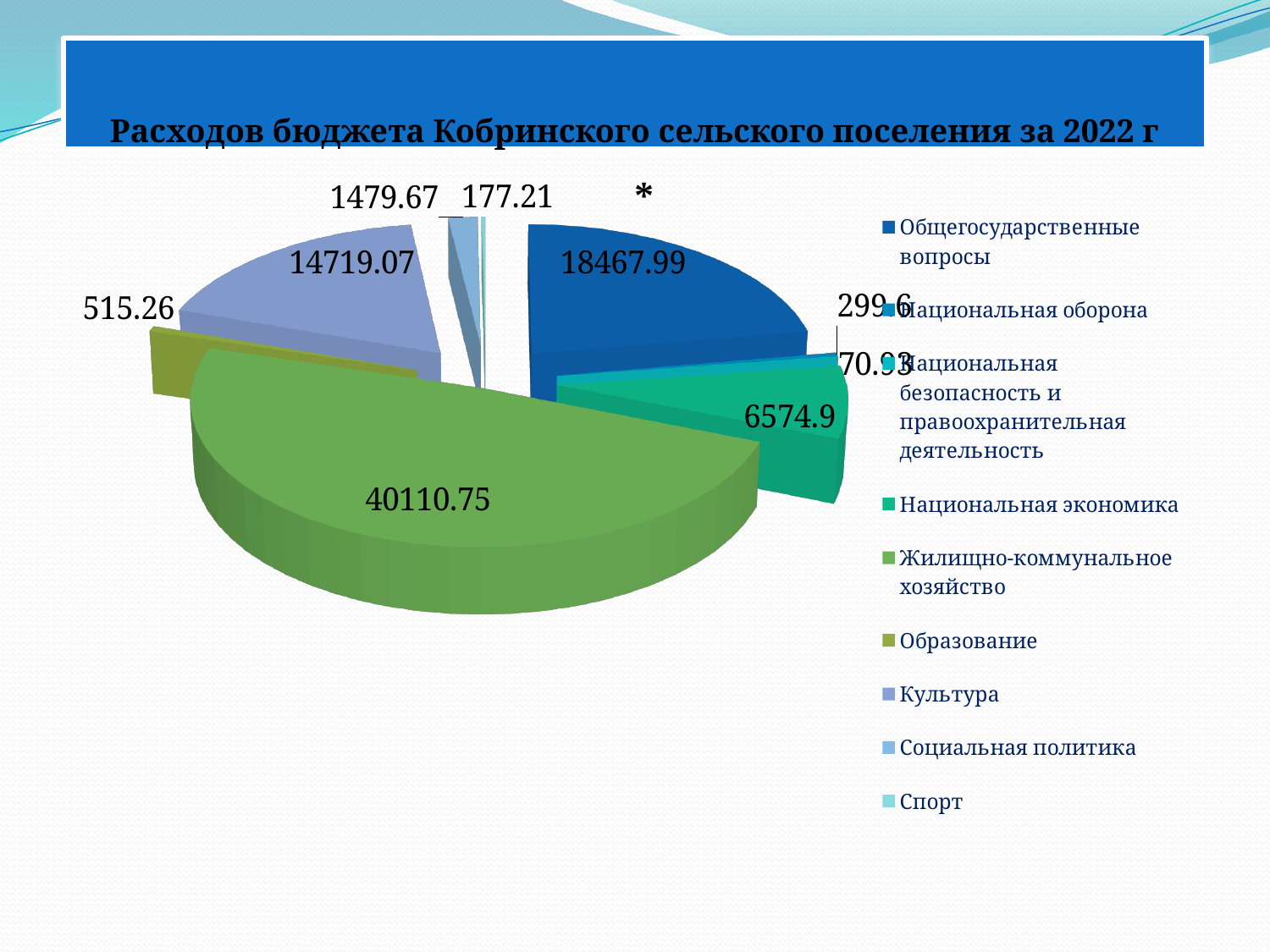
What is the value shown for Спорт? 177.21 What is the difference between the value for Жилищно-коммунальное хозяйство and the value for Общегосударственные вопросы? 21642.76 Which is larger, the value for Общегосударственные вопросы or the value for Культура? Общегосударственные вопросы What is the value shown for Культура? 14719.07 What kind of chart is shown on the slide? pie chart What is the value shown for Социальная политика? 1479.67 What is the value shown for Образование? 515.26 How many categories does the legend list? 9 Which category has the largest slice of the pie? Жилищно-коммунальное хозяйство What is the value shown for Общегосударственные вопросы? 18467.99 What is the value shown for Национальная экономика? 6574.9